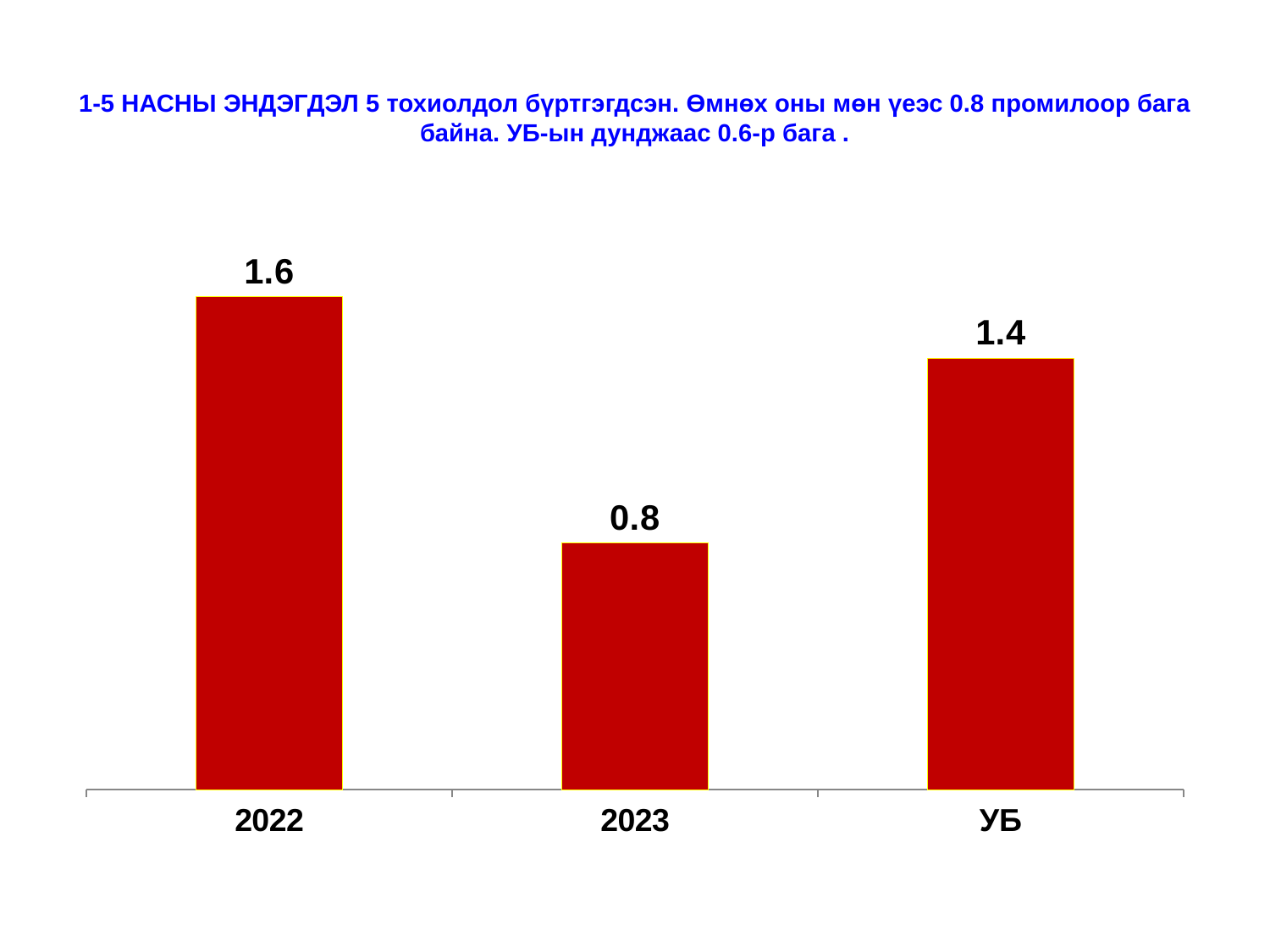
Does the value rise or fall from 2022 to 2023? fall Which category has the lowest value? 2023 What is the value for УБ? 1.4 How many categories are shown on the x axis? 3 What is the difference between the values for 2022 and 2023? 0.8 What is the value for 2023? 0.8 What kind of chart is shown on the slide? bar chart What is the difference between the values for УБ and 2023? 0.6 Which category has the highest value? 2022 What is the value for 2022? 1.6 What colour are the bars in the chart? red Which is larger, the value for 2022 or the value for УБ? 2022